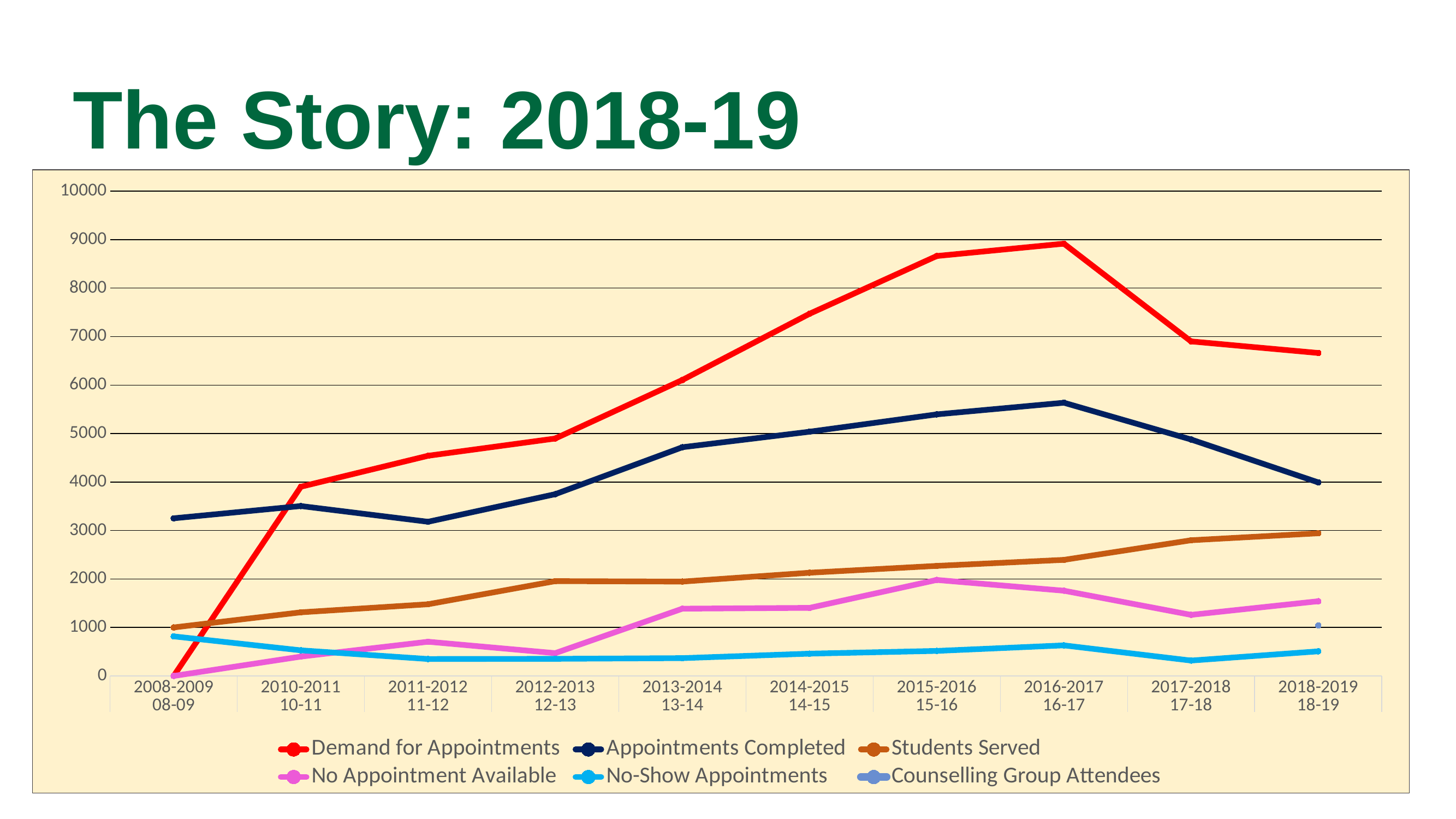
How many series does the legend list? 6 In which year does Demand for Appointments reach its highest value? 2016-2017 Is the value for Demand for Appointments in 2015-2016 greater or less than 8000? greater In 2018-2019, which is larger: Demand for Appointments or Appointments Completed? Demand for Appointments Is the value for Appointments Completed in 2013-2014 greater or less than 4000? greater What colour is the Demand for Appointments line? red Is the value for No Appointment Available in 2008-2009 greater or less than 1000? less Does Demand for Appointments rise or fall from 2016-2017 to 2018-2019? fall In which year is Demand for Appointments at its lowest? 2008-2009 How many academic years are plotted along the x axis? 10 In which year does Appointments Completed reach its highest value? 2016-2017 What kind of chart is shown on the slide? line chart